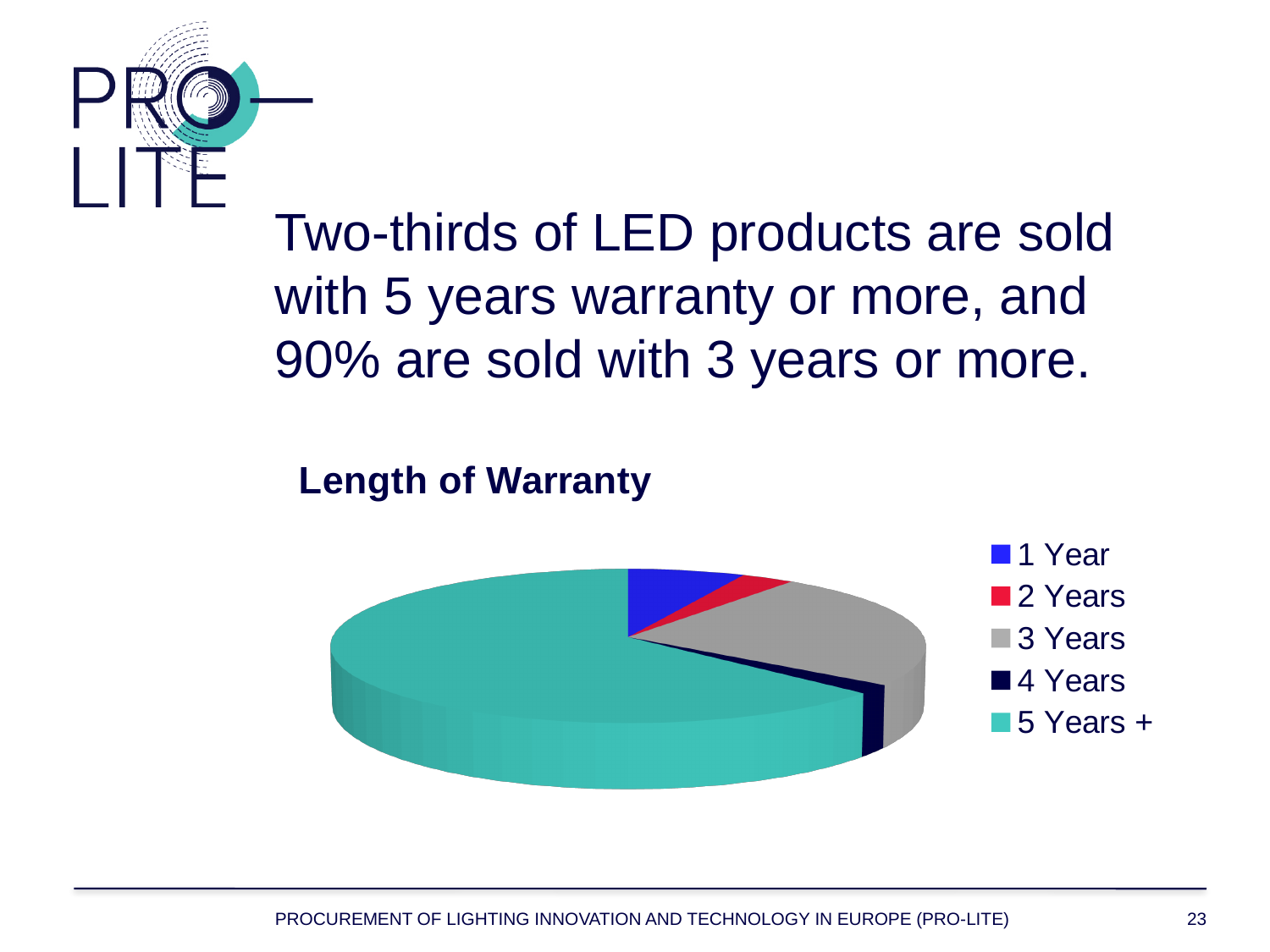
Which legend entry is shown in red? 2 Years Which slice is larger, 3 Years or 1 Year? 3 Years How many warranty-length categories does the pie chart show? 5 What is the title of the chart? Length of Warranty How many entries does the chart legend list? 5 What kind of chart is shown on the slide? Pie chart Which warranty length has the largest slice of the pie? 5 Years + Which slice is larger, 1 Year or 2 Years? 1 Year Which warranty length has the second-largest slice of the pie? 3 Years Which slice is larger, 5 Years + or 3 Years? 5 Years +